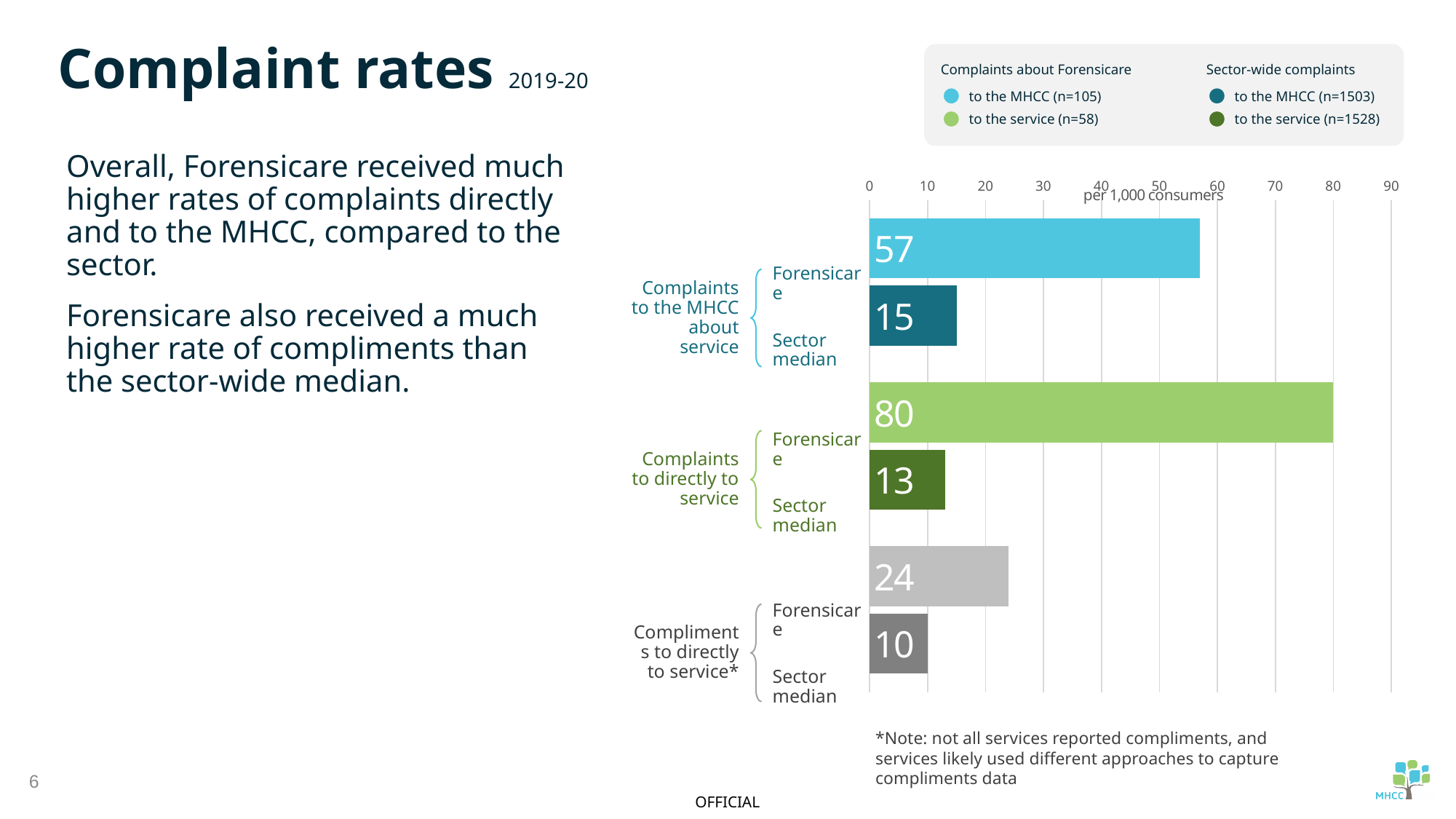
Which bar has the highest value on the chart? Forensicare, complaints directly to service Which bar has the lowest value on the chart? Sector median, compliments directly to service What is the sector median value for compliments directly to service? 10 How many bars are plotted on the chart? 6 What is the sector median value for complaints to the MHCC about service? 15 What unit does the x axis of the chart use? per 1,000 consumers Which is larger: the Forensicare value for complaints to the MHCC about service or the Forensicare value for compliments directly to service? Complaints to the MHCC about service What kind of chart is shown on the slide? Bar chart What is the difference between the Forensicare and sector median values for compliments directly to service? 14 What is the Forensicare value for complaints to the MHCC about service? 57 What is the difference between the Forensicare and sector median values for complaints directly to service? 67 What is the Forensicare value for complaints directly to service? 80